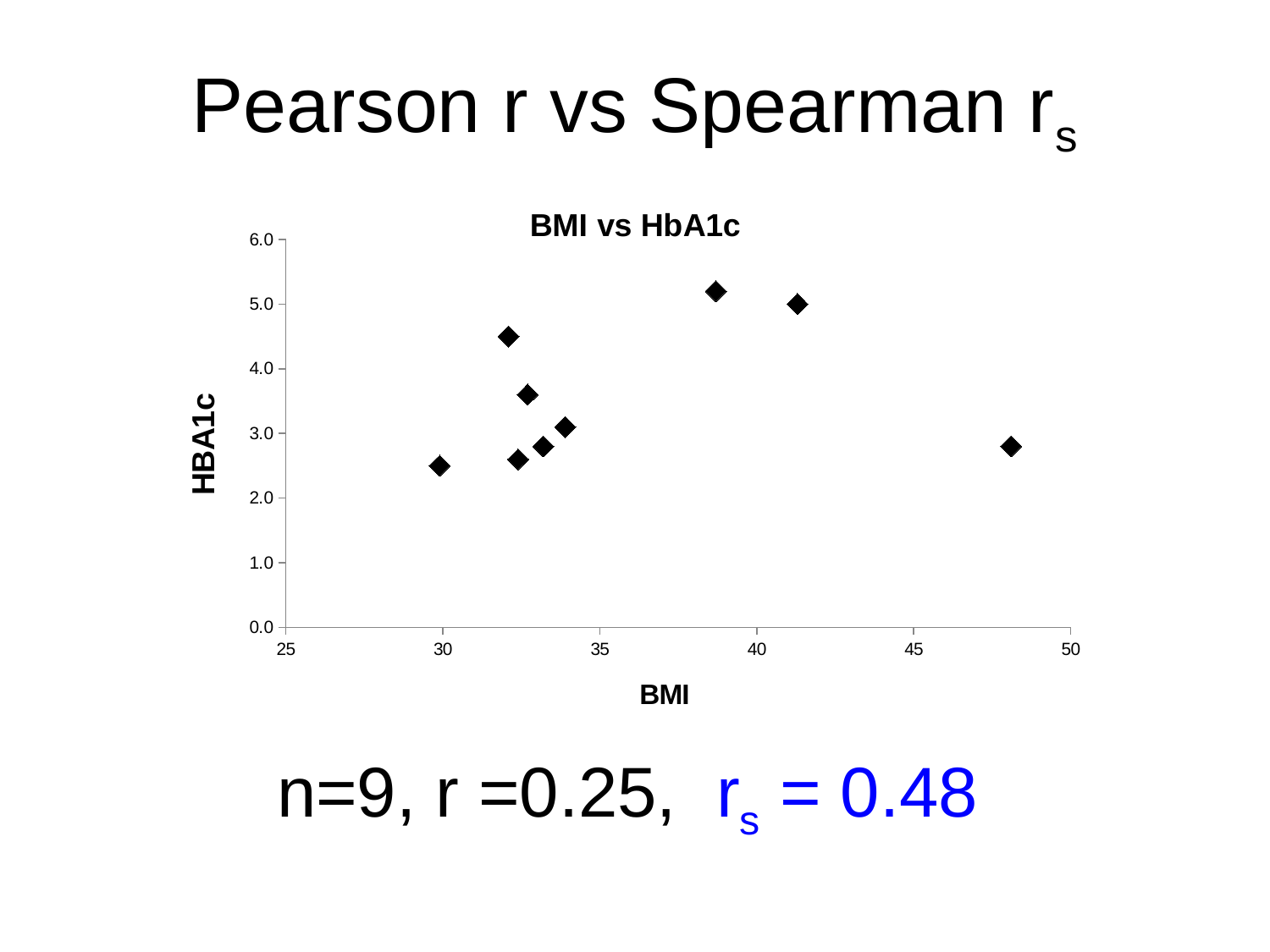
How many points have an HbA1c value above 4.0? 3 How many points have a BMI greater than 40? 2 Which has the higher HbA1c value: the point with the lowest BMI or the point with the highest BMI? The point with the highest BMI Is the HbA1c value of the point with the lowest BMI greater or less than 3.0? less How many points have a BMI less than 35? 6 Is the HbA1c value of the point with the highest BMI greater or less than 3.0? less What is the maximum value shown on the y axis? 6.0 Is the BMI of the rightmost point greater or less than 45? greater What kind of chart is shown on the slide? Scatter plot What is the title of the chart? BMI vs HbA1c What is the label of the x axis? BMI